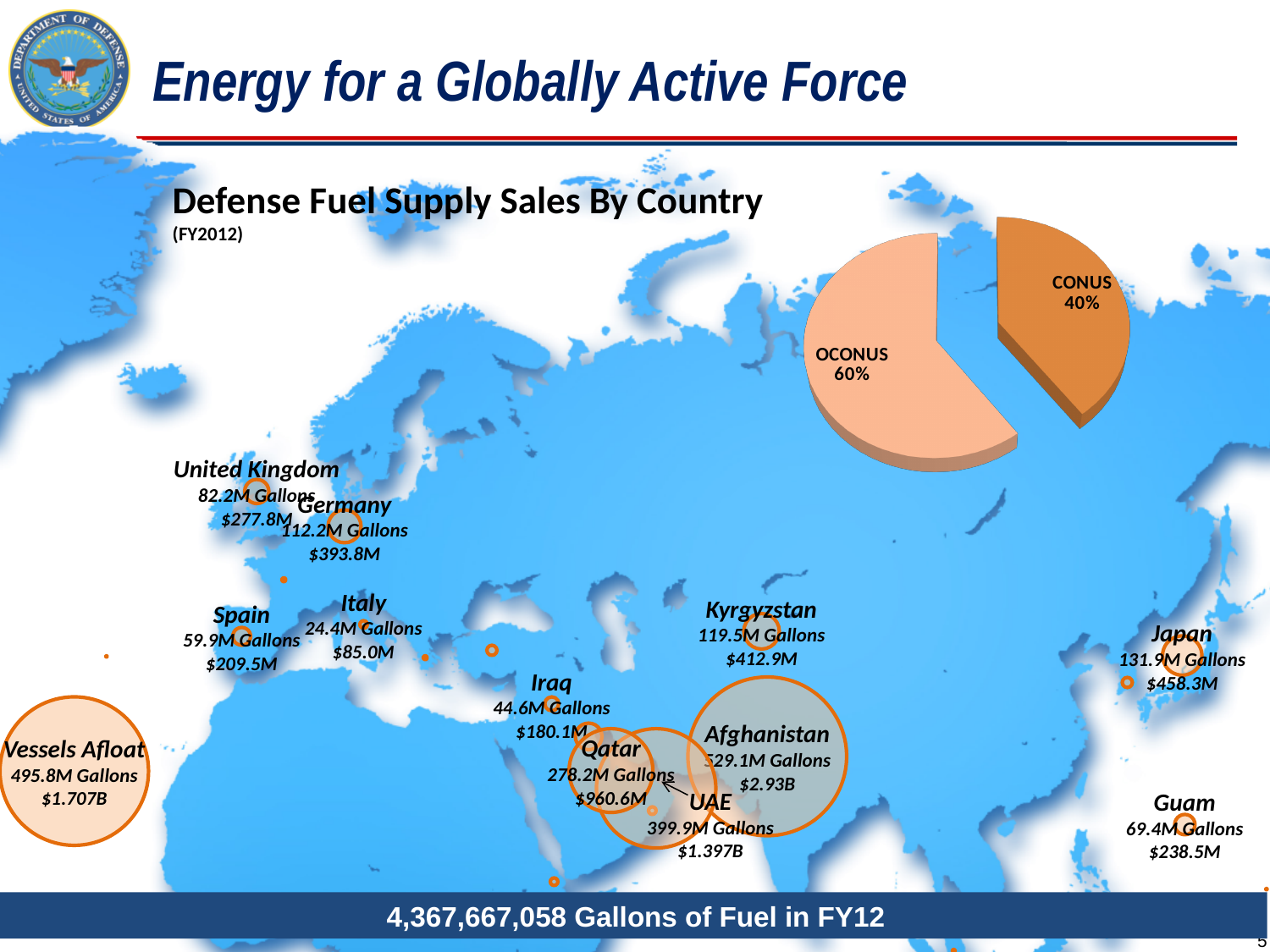
On the map, what is the dollar value shown for Afghanistan? $2.93B In the pie chart, which slice is the darker orange and pulled out from the rest? CONUS In the pie chart, by how many percentage points does OCONUS exceed CONUS? 20 percentage points On the map, how many gallons of fuel are shown for Japan? 131.9M Gallons How many slices does the pie chart have? 2 In the pie chart, what share of Defense Fuel Supply Sales is OCONUS? 60% In the pie chart, what share of Defense Fuel Supply Sales is CONUS? 40% On the map, how many gallons of fuel are shown for Vessels Afloat? 495.8M Gallons In the pie chart, which category has the smallest share? CONUS In the pie chart, which slice is larger, CONUS or OCONUS? OCONUS What kind of chart is shown in the upper right of the slide? Pie chart What is the title of the chart on the slide, and for which fiscal year? Defense Fuel Supply Sales By Country (FY2012)